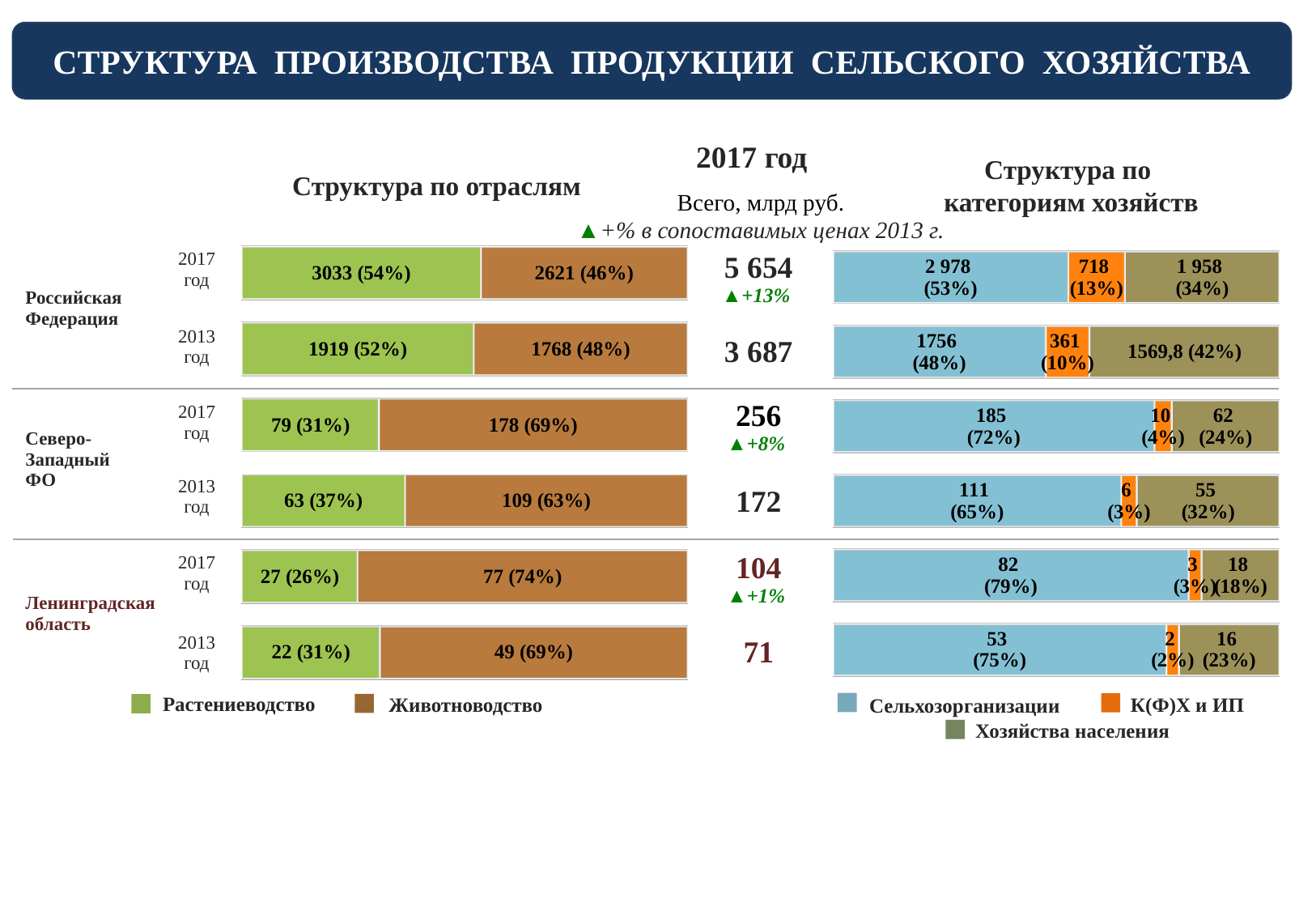
In the 'Структура по отраслям' chart, what is the value for Животноводство for Ленинградская область in 2013? 49 (69%) What kind of chart is used in the 'Структура по отраслям' section? Stacked bar chart What is the total (Всего, млрд руб.) for Северо-Западный ФО in 2017? 256 In the 'Структура по отраслям' chart, which is larger for Ленинградская область in 2017: Растениеводство or Животноводство? Животноводство How many series does the legend of the 'Структура по категориям хозяйств' chart list? 3 In the 'Структура по отраслям' chart, what is the difference between Животноводство and Растениеводство for Северо-Западный ФО in 2017? 99 In the 'Структура по отраслям' chart, what is the value for Растениеводство for Российская Федерация in 2017? 3033 (54%) In the 'Структура по категориям хозяйств' chart, what is the value for К(Ф)Х и ИП for Ленинградская область in 2017? 3 (3%) What percentage growth in comparable 2013 prices is shown for Российская Федерация in 2017? +13% In the 'Структура по категориям хозяйств' chart, what is the value for Сельхозорганизации for Северо-Западный ФО in 2017? 185 (72%) In the 'Структура по категориям хозяйств' chart, what is the value for Хозяйства населения for Российская Федерация in 2013? 1569,8 (42%) In the 'Структура по категориям хозяйств' chart, which category has the smallest value for Российская Федерация in 2017? К(Ф)Х и ИП